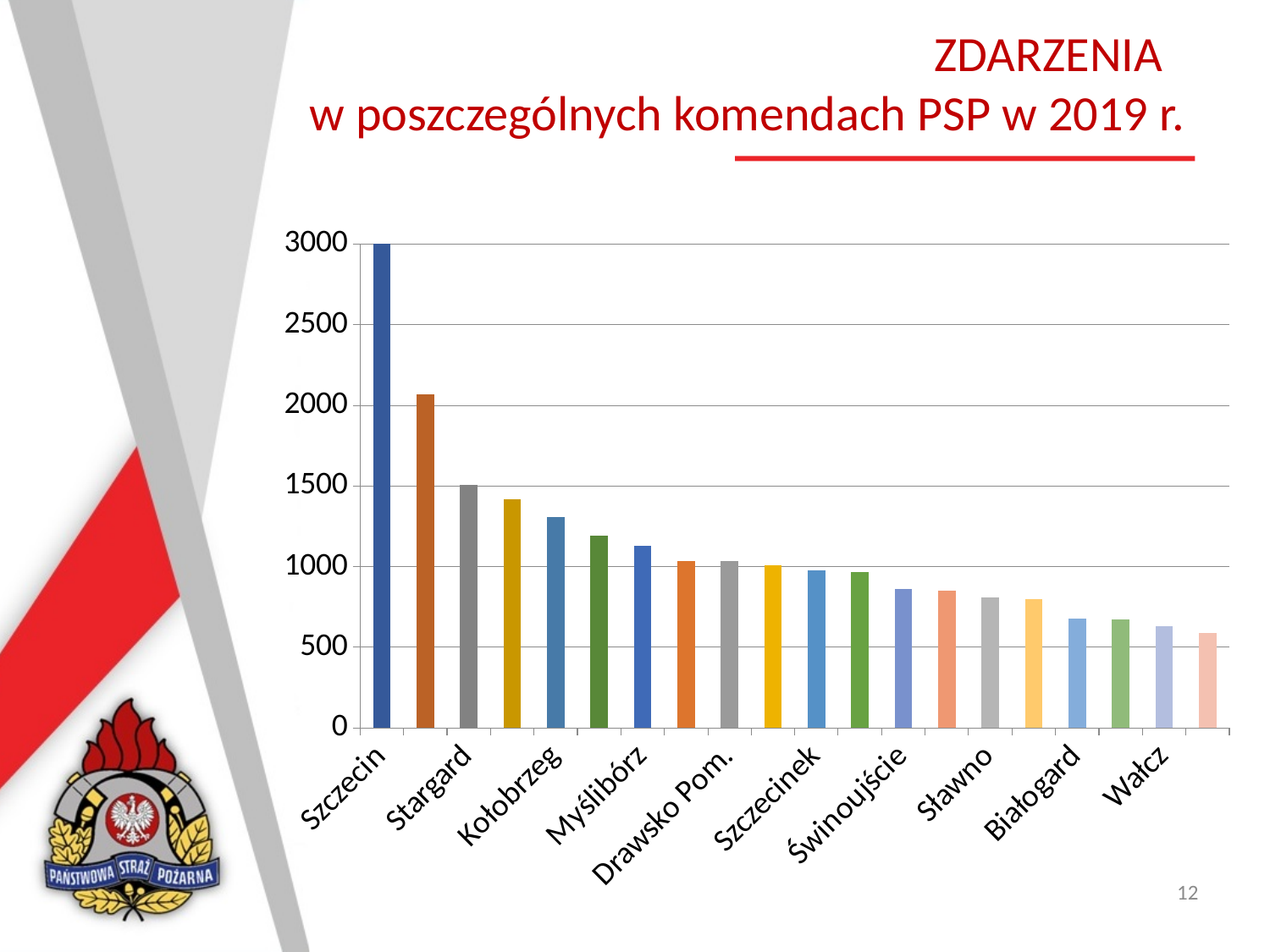
Is the value for Stargard greater or less than 2000? less What year does the chart title say the incidents refer to? 2019 What kind of chart is shown on the slide? bar chart How many bars are plotted in the chart? 20 Is the value for Świnoujście greater or less than 1000? less Is the value for Kołobrzeg greater or less than 1000? greater Which is larger, the value for Myślibórz or the value for Białogard? Myślibórz Do the values rise or fall moving from left to right along the x axis? fall Which is larger, the value for Kołobrzeg or the value for Sławno? Kołobrzeg Which command (komenda) has the highest number of incidents in the chart? Szczecin